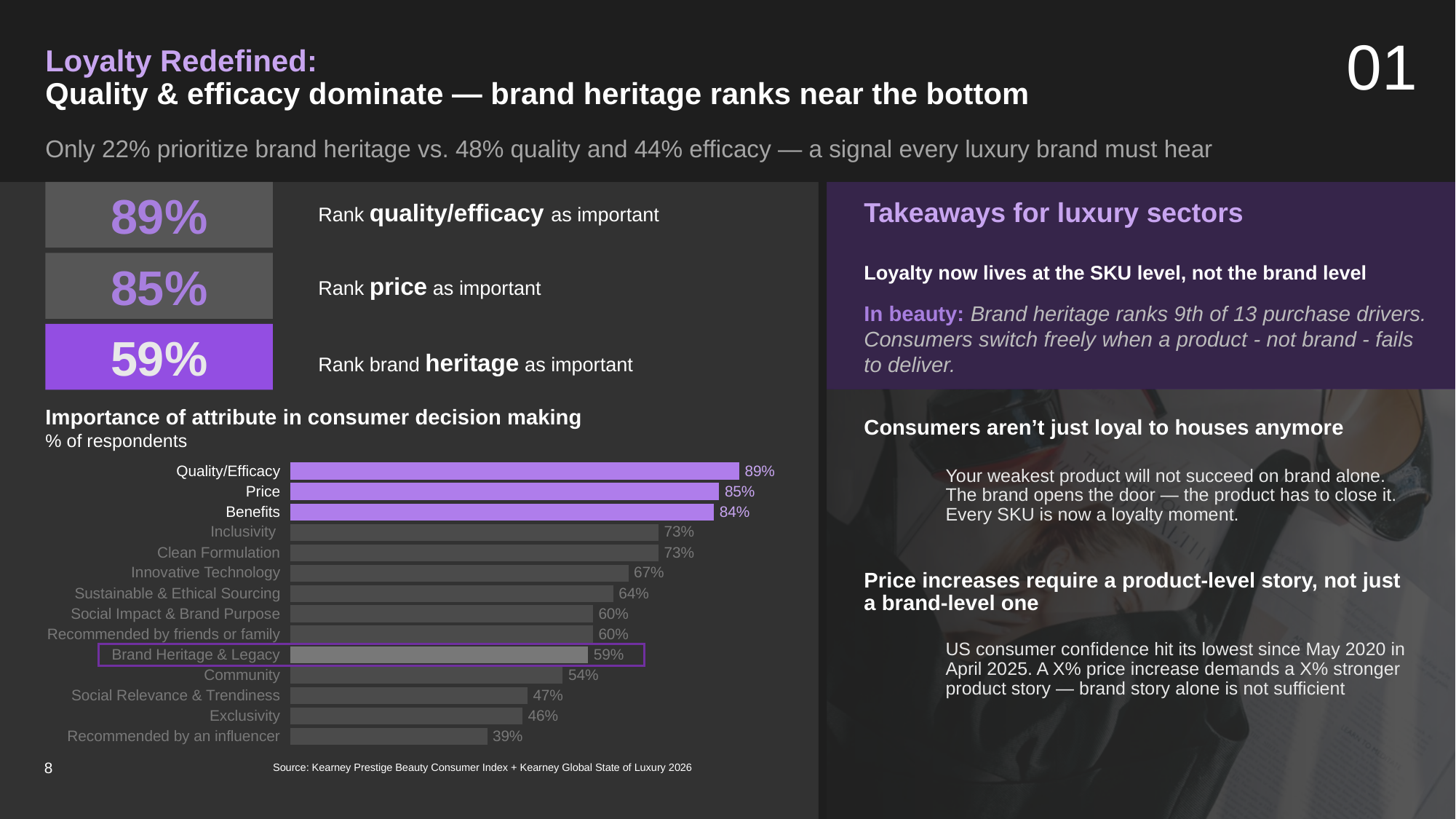
What is the difference between the values for Quality/Efficacy and Brand Heritage & Legacy in the bar chart? 30% What is the value for Brand Heritage & Legacy in the bar chart? 59% What kind of chart is shown under the title "Importance of attribute in consumer decision making"? Bar chart How many attributes are plotted in the bar chart? 14 Which attribute has the lowest value in the bar chart? Recommended by an influencer What is the difference between the values for Price and Community in the bar chart? 31% What is the value for Recommended by an influencer in the bar chart? 39% What is the value for Innovative Technology in the bar chart? 67% Do the values in the bar chart rise or fall from the top bar to the bottom bar? Fall In the bar chart, which is larger: the value for Sustainable & Ethical Sourcing or the value for Community? Sustainable & Ethical Sourcing Which attribute has the highest value in the bar chart? Quality/Efficacy What unit is stated under the bar chart's title? % of respondents